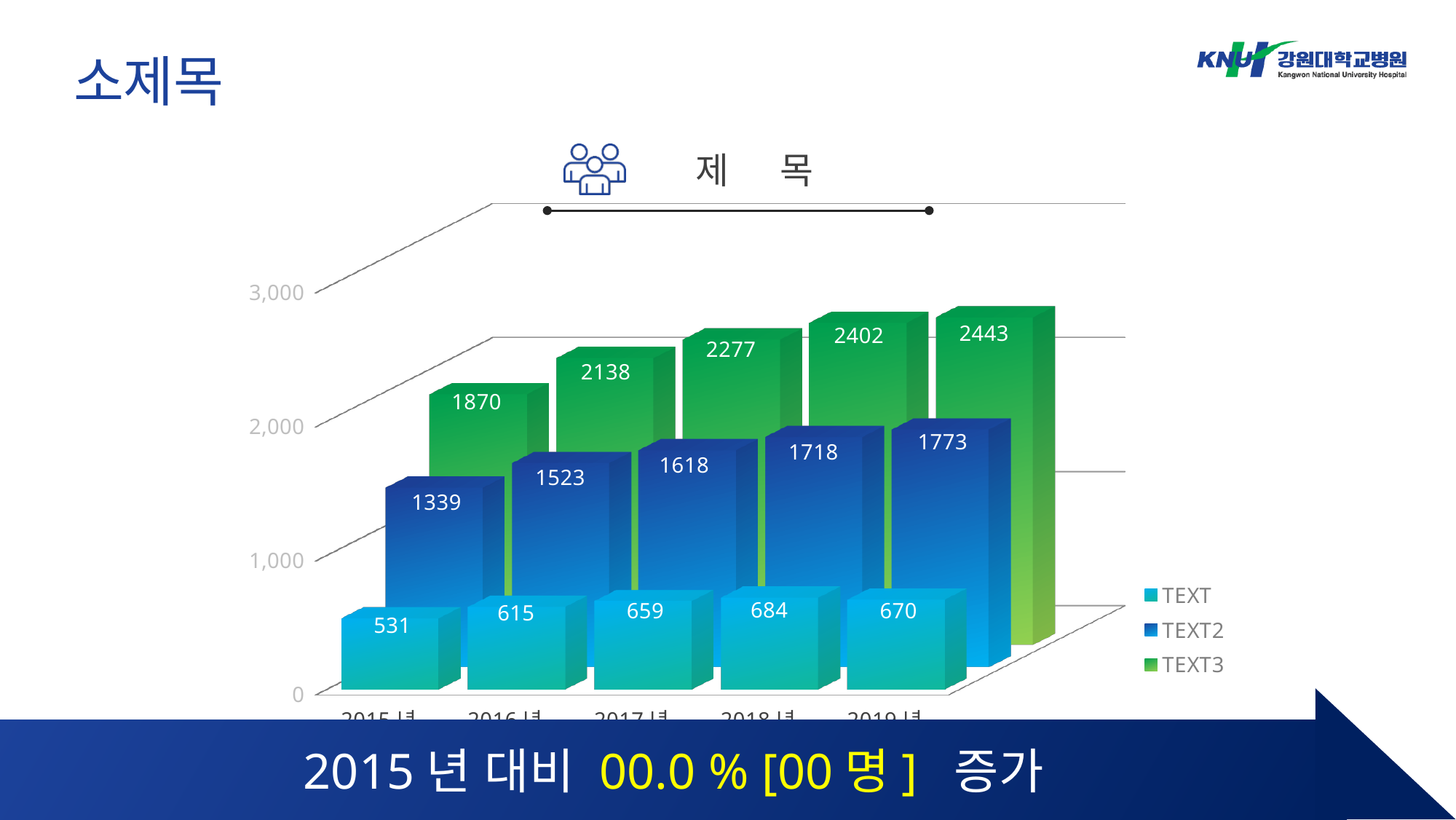
How many series does the legend list? 3 What is the difference between the TEXT3 values for 2019년 and 2015년? 573 What is the value of the TEXT3 series for 2017년? 2277 In which year is the TEXT series lowest? 2015년 Does the TEXT2 series rise or fall from 2015년 to 2019년? Rise What is the value of the TEXT series for 2015년? 531 What is the value of the TEXT2 series for 2019년? 1773 In which year does the TEXT series reach its highest value? 2018년 In which year is the TEXT3 series highest? 2019년 For 2016년, which series has the larger value, TEXT or TEXT2? TEXT2 How many years are shown on the x axis? 5 What kind of chart is shown on the slide? Bar chart